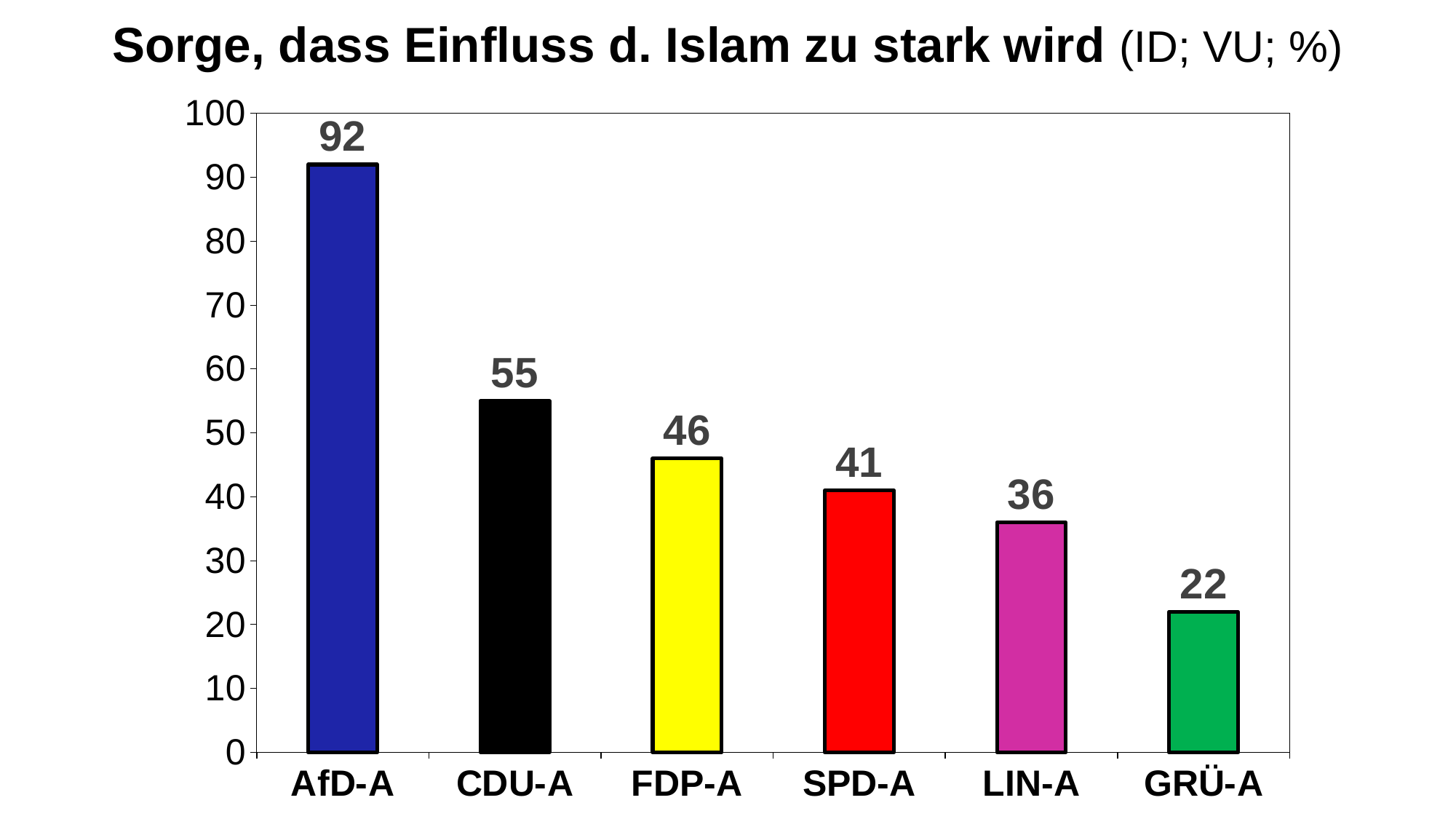
Which category has the highest value? AfD-A How many categories are shown on the x axis? 6 Which category has the lowest value? GRÜ-A Is the value for LIN-A greater or less than 40? less Do the values rise or fall from left to right along the x axis? fall What is the value for SPD-A? 41 Which is larger, the value for CDU-A or the value for FDP-A? CDU-A What kind of chart is shown on the slide? bar chart What is the value for GRÜ-A? 22 What is the value for AfD-A? 92 What is the difference between the values for FDP-A and LIN-A? 10 What is the difference between the values for AfD-A and CDU-A? 37